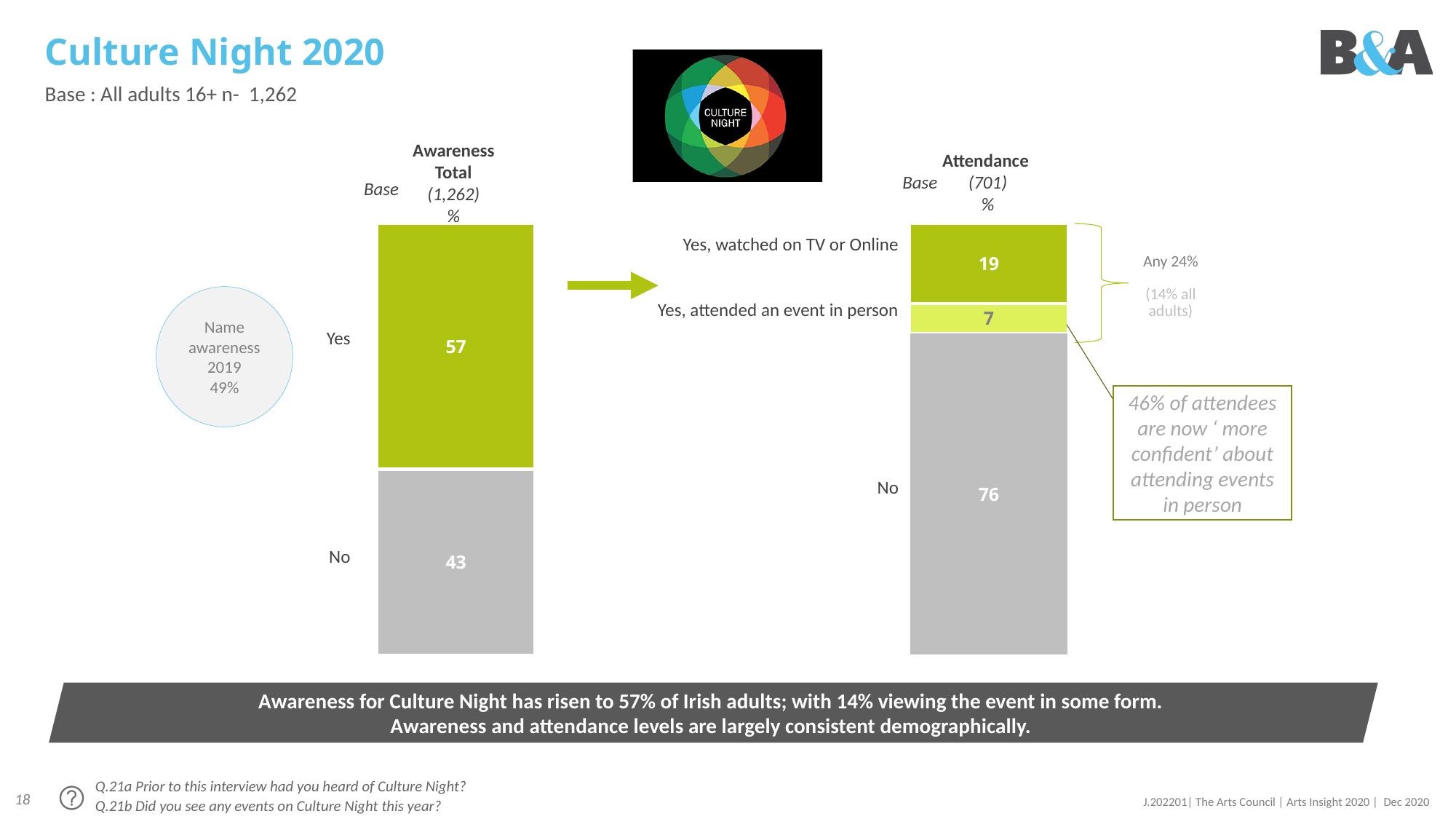
In the Awareness chart, which is larger, Yes or No? Yes In the Attendance chart, which segment is the largest? No In the Attendance chart, what is the difference between those who watched on TV or Online and those who attended in person? 12 In the Attendance chart, which segment is the smallest? Yes, attended an event in person In the Attendance chart, what percentage attended an event in person? 7 In the Awareness chart, what percentage of adults said Yes, they had heard of Culture Night? 57 What kind of chart is used for Awareness and Attendance on this slide? Stacked bar chart In the Attendance chart, what percentage watched on TV or Online? 19 In the Awareness chart, what percentage of adults said No? 43 How many segments does the Attendance bar have? 3 In the Attendance chart, what percentage answered No? 76 In the Awareness chart, what is the difference between the Yes and No percentages? 14